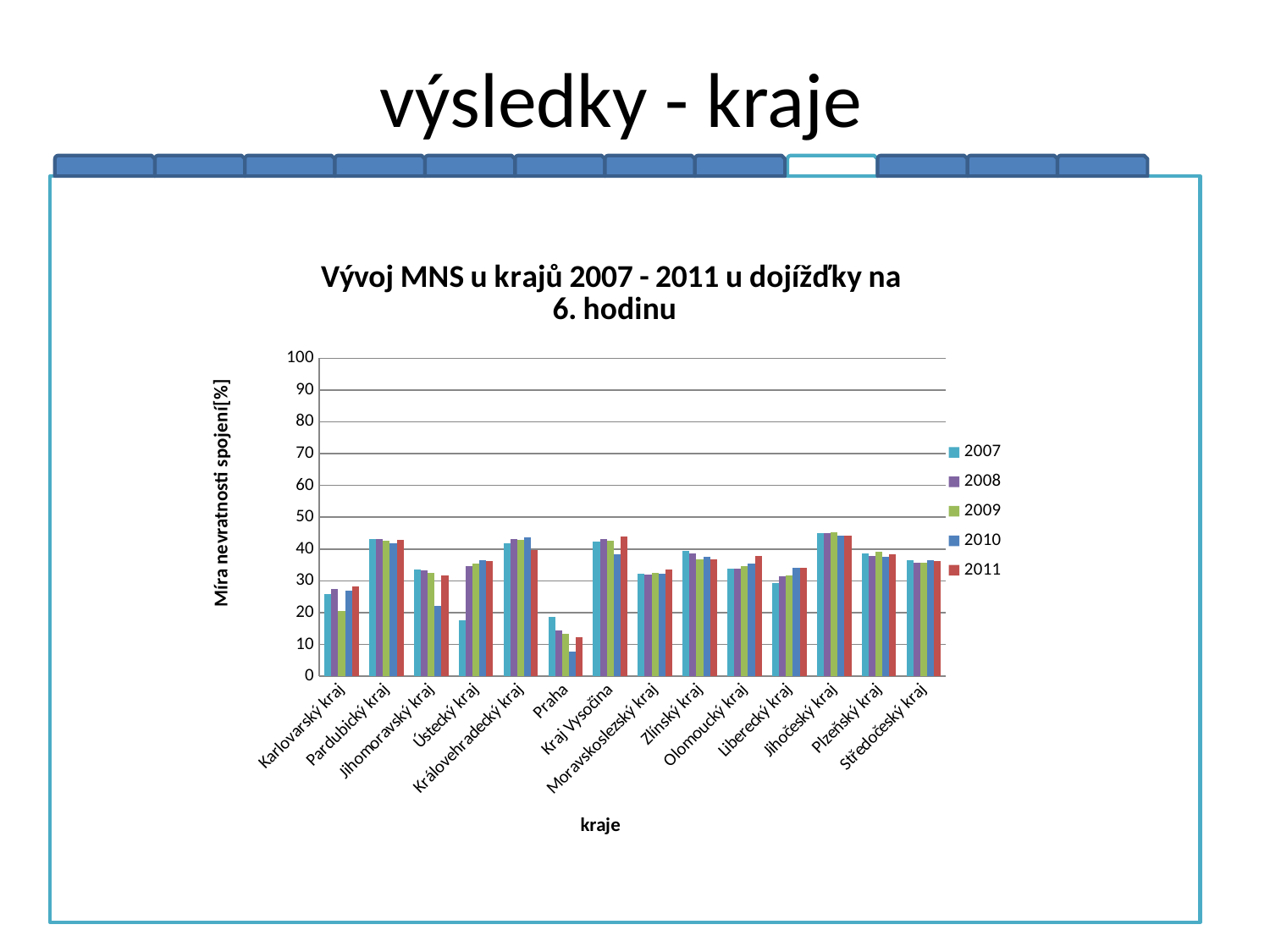
What kind of chart is shown on the slide? bar chart Is the 2007 value for Praha greater or less than 20? less How many regions (kraje) are shown on the x axis? 14 What is the label of the vertical axis? Míra nevratnosti spojení[%] Which is larger, the 2007 value for Pardubický kraj or the 2007 value for Karlovarský kraj? Pardubický kraj What is the title of the chart? Vývoj MNS u krajů 2007 - 2011 u dojížďky na 6. hodinu Is the 2007 value for Jihočeský kraj greater or less than 40? greater Is the 2009 value for Jihomoravský kraj greater or less than 30? greater Which region has the highest values across the years? Jihočeský kraj How many series does the legend list? 5 Which region has the lowest values across the years? Praha